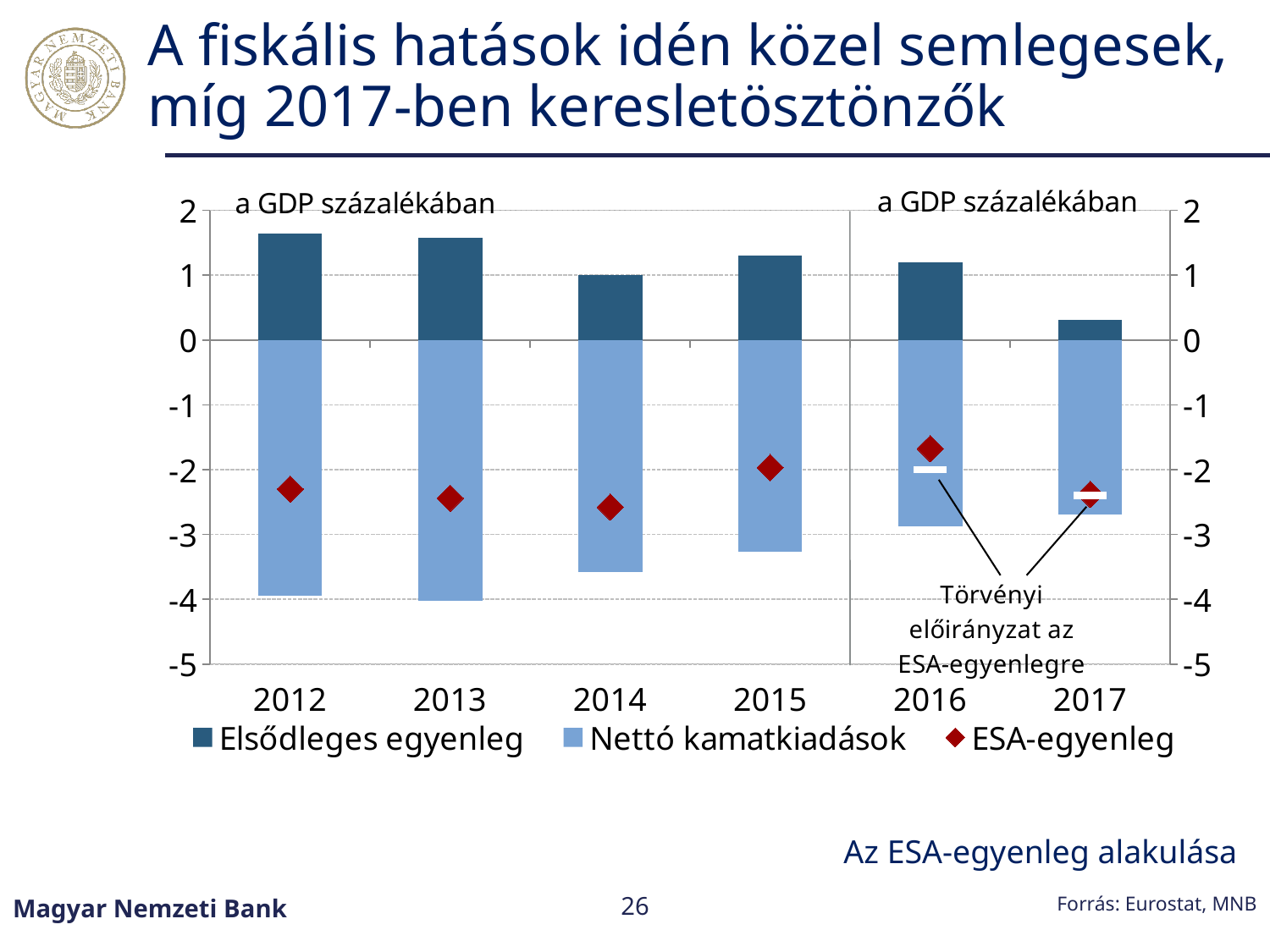
Does the Elsődleges egyenleg series generally rise or fall from 2012 to 2017? fall Which year has the highest ESA-egyenleg value? 2016 How many years are shown on the x axis of the chart? 6 Is the value of Elsődleges egyenleg for 2012 greater or less than 1? greater Is the value of Elsődleges egyenleg for 2017 greater or less than 1? less Is the value of Nettó kamatkiadások for 2017 greater or less than -3? greater Which year has the lowest value for Elsődleges egyenleg? 2017 What kind of chart is shown on the slide? bar chart How many series does the chart legend list? 3 Which year has the larger Elsődleges egyenleg value, 2014 or 2015? 2015 What unit label is shown at the top of the chart's axes? a GDP százalékában